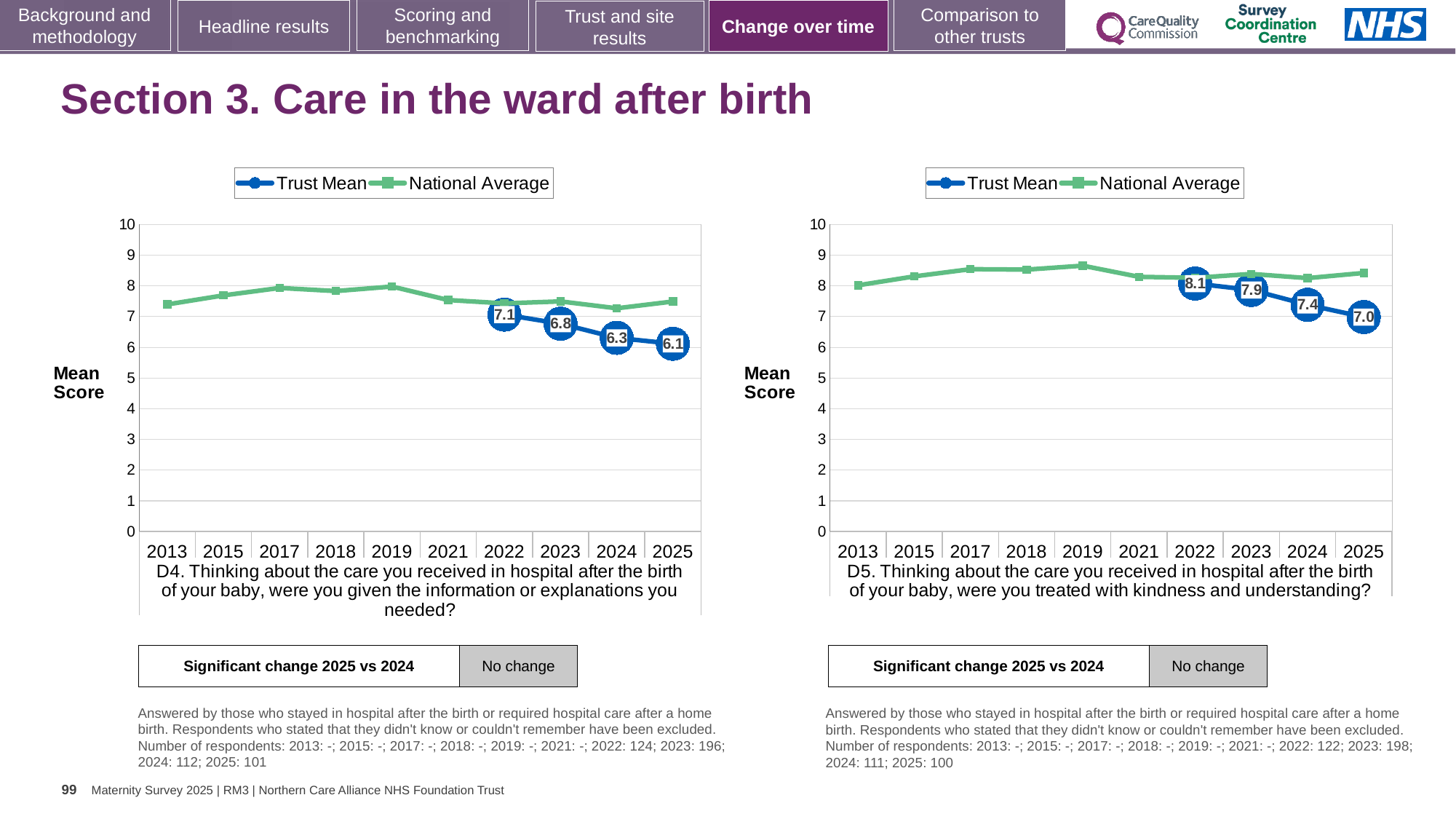
In the right chart (D5), what is the difference between the Trust Mean scores for 2022 and 2023? 0.2 In the right chart (D5), what is the Trust Mean score for 2025? 7.0 In the right chart (D5), which year has the highest Trust Mean score? 2022 In the left chart (D4), which year has the lowest Trust Mean score? 2025 What kind of chart is the right chart (D5)? line chart In the right chart (D5), is the National Average for 2019 greater or less than 8? greater In the left chart (D4), what is the Trust Mean score for 2025? 6.1 In the left chart (D4), what is the Trust Mean score for 2022? 7.1 In the right chart (D5), what is the Trust Mean score for 2024? 7.4 In the left chart (D4), what is the difference between the Trust Mean scores for 2022 and 2025? 1.0 How many series does the legend of the left chart (D4) list? 2 In the left chart (D4), does the Trust Mean rise or fall from 2022 to 2025? fall